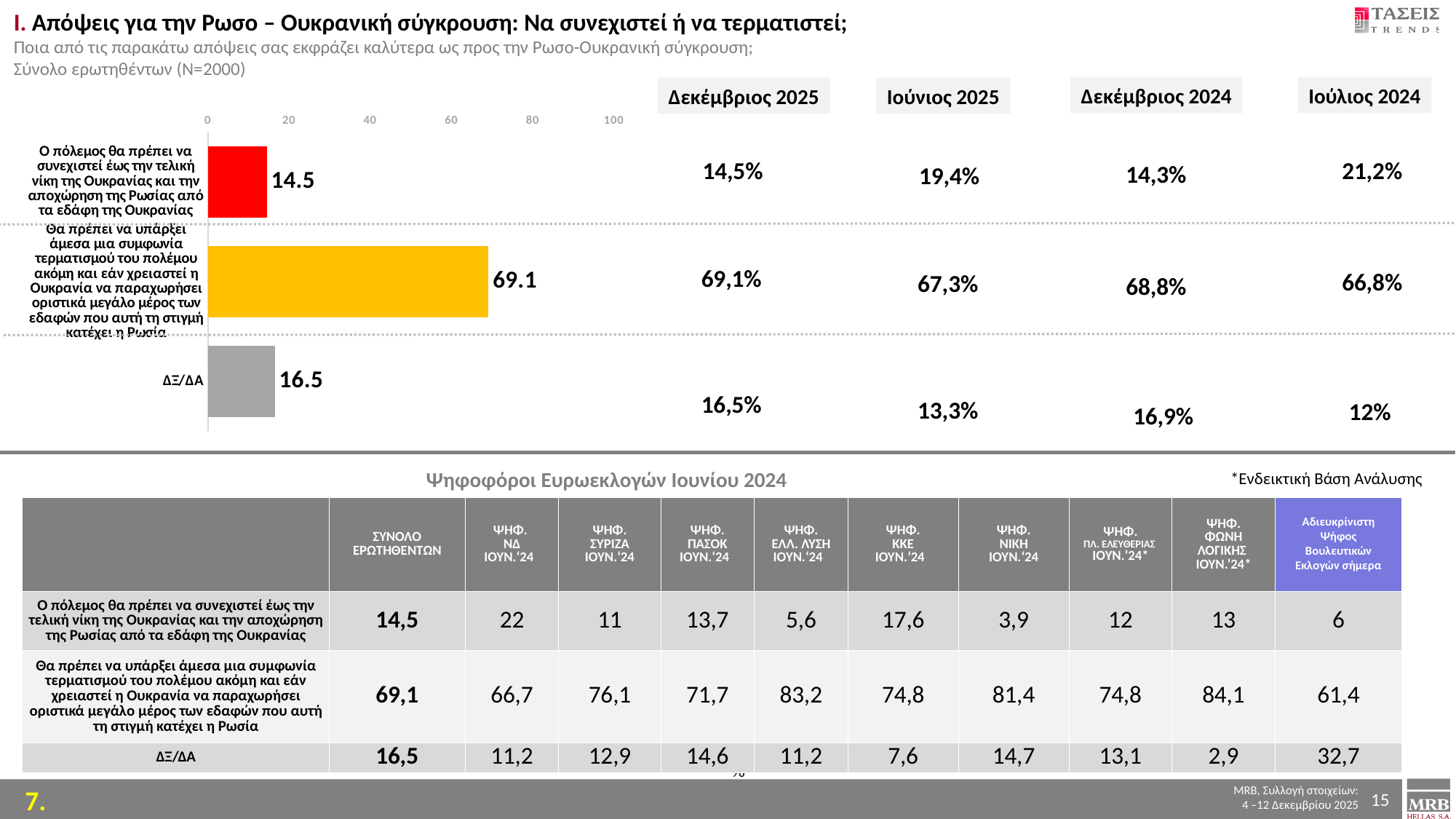
What colour is the bar for ΔΞ/ΔΑ? grey What is the difference between the value for the immediate agreement opinion (69.1) and the value for ΔΞ/ΔΑ (16.5)? 52.6 What is the value of the bar for ΔΞ/ΔΑ? 16.5 What colour is the bar for the opinion that the war should continue until Ukraine's final victory? red Which is larger: the value for ΔΞ/ΔΑ or the value for the opinion that the war should continue until Ukraine's final victory? ΔΞ/ΔΑ How many categories (bars) does the chart show? 3 Which category has the lowest value in the chart? Ο πόλεμος θα πρέπει να συνεχιστεί έως την τελική νίκη της Ουκρανίας What is the value of the bar for the opinion that there should be an immediate agreement to end the war (Θα πρέπει να υπάρξει άμεσα μια συμφωνία τερματισμού του πολέμου)? 69.1 What type of chart is shown on the slide? bar chart Which category has the highest value in the chart? Θα πρέπει να υπάρξει άμεσα μια συμφωνία τερματισμού του πολέμου Is the value for the immediate agreement opinion greater or less than 60? greater What is the value of the bar for the opinion that the war should continue until the final victory of Ukraine (Ο πόλεμος θα πρέπει να συνεχιστεί έως την τελική νίκη της Ουκρανίας)? 14.5